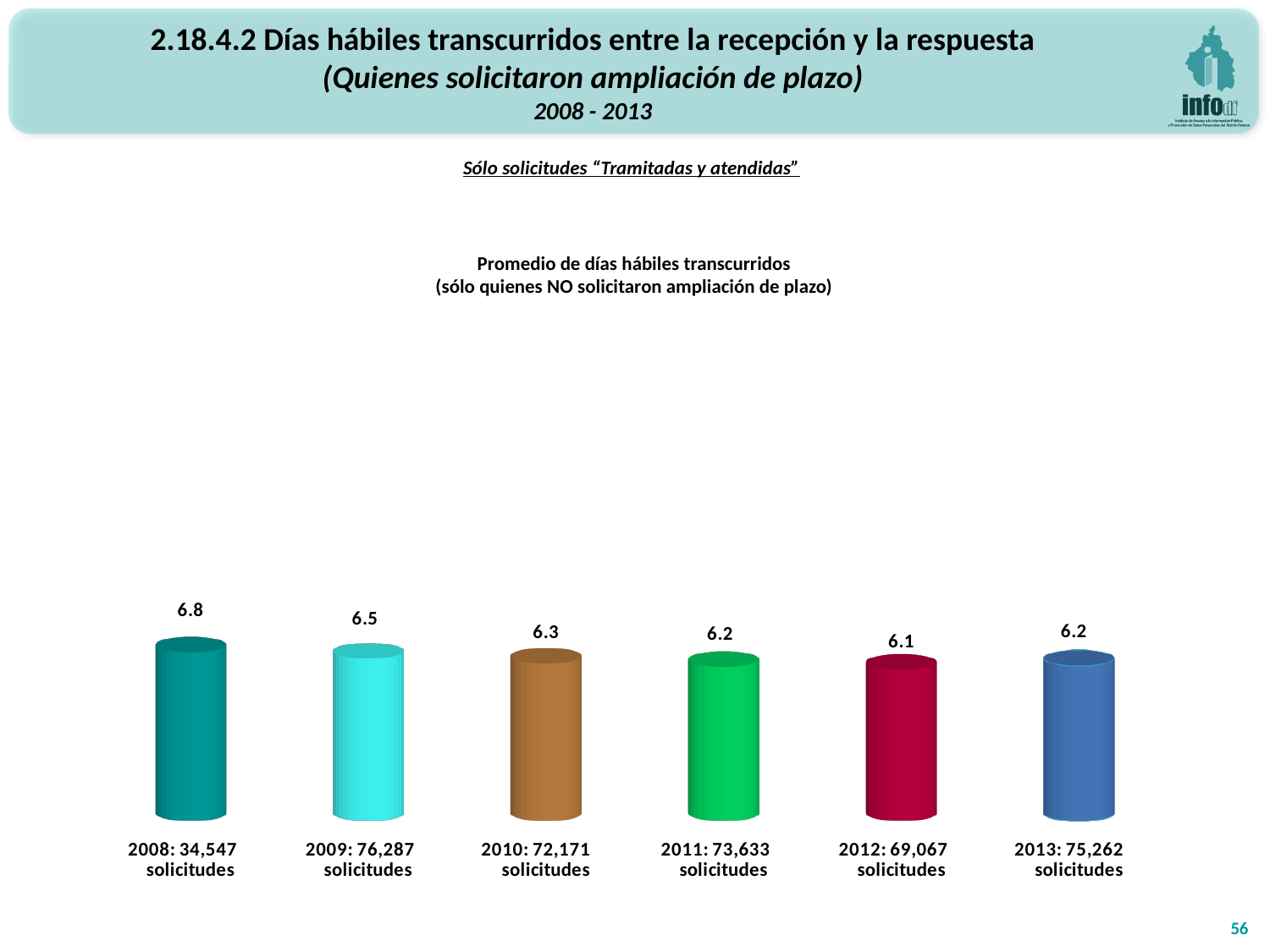
How many years (bars) are shown in the chart? 6 Which year has the highest average number of business days? 2008 What is the value of the bar for 2012? 6.1 What is the difference between the values for 2009 and 2010? 0.2 What kind of chart is shown on the slide? Bar chart What value is shown for 2010? 6.3 What is the average number of business days shown for 2008? 6.8 Which year has the lowest average number of business days? 2012 Which is larger, the value for 2009 or the value for 2011? 2009 Do the values generally rise or fall from 2008 to 2012? Fall What is the difference between the values for 2008 and 2013? 0.6 How many solicitudes are indicated in the label for 2011? 73,633